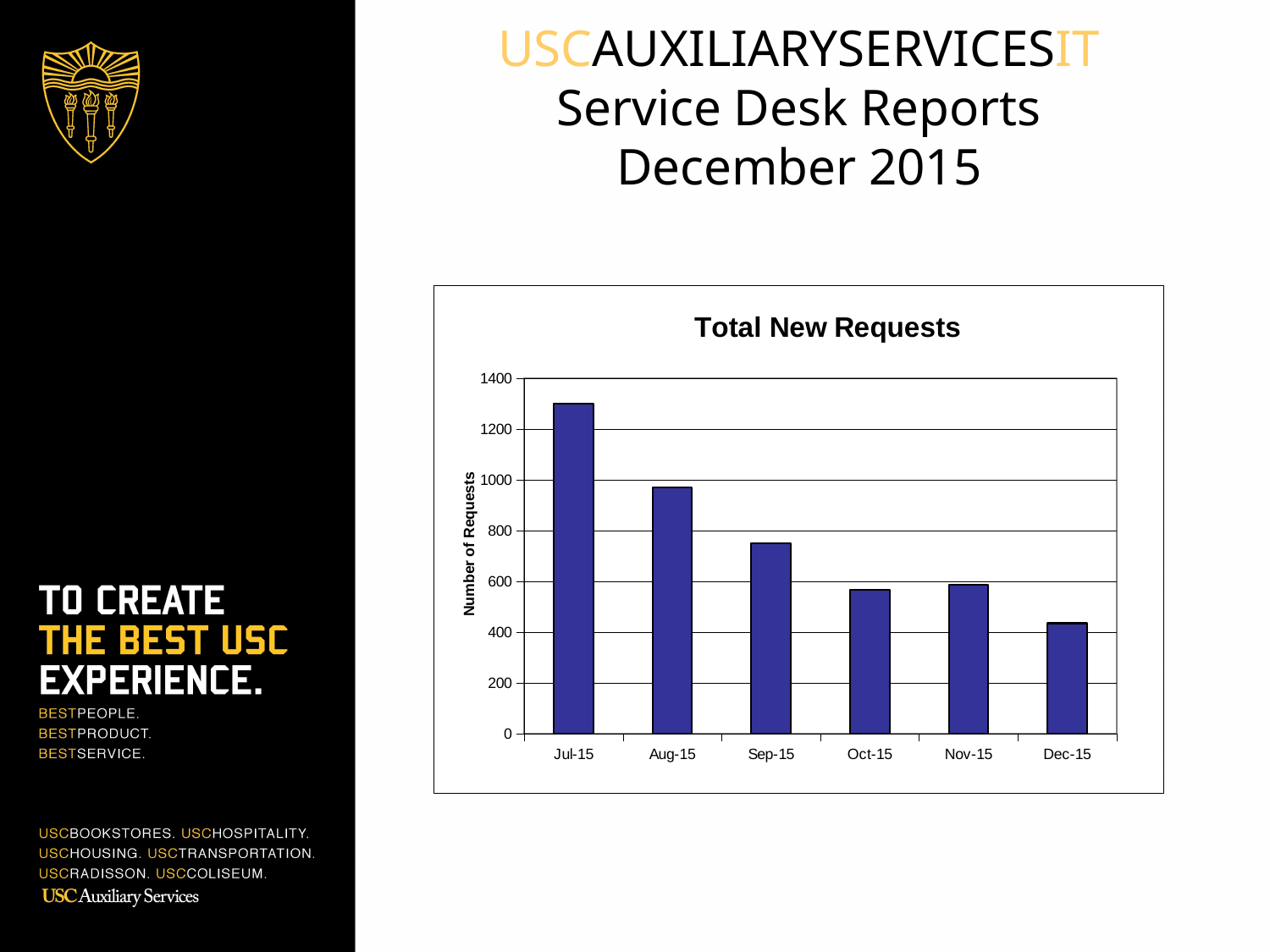
Is the value for Jul-15 greater or less than 1200? greater Do the values generally rise or fall from Jul-15 to Dec-15? fall Which is larger, the value for Sep-15 or the value for Dec-15? Sep-15 How many months are shown on the x axis of the chart? 6 Is the value for Dec-15 greater or less than 400? greater Is the value for Aug-15 greater or less than 1000? less What kind of chart is shown on the slide? bar chart Which month has the lowest number of requests? Dec-15 What is the title of the chart? Total New Requests Which month has the highest number of requests? Jul-15 What is the label on the vertical axis of the chart? Number of Requests